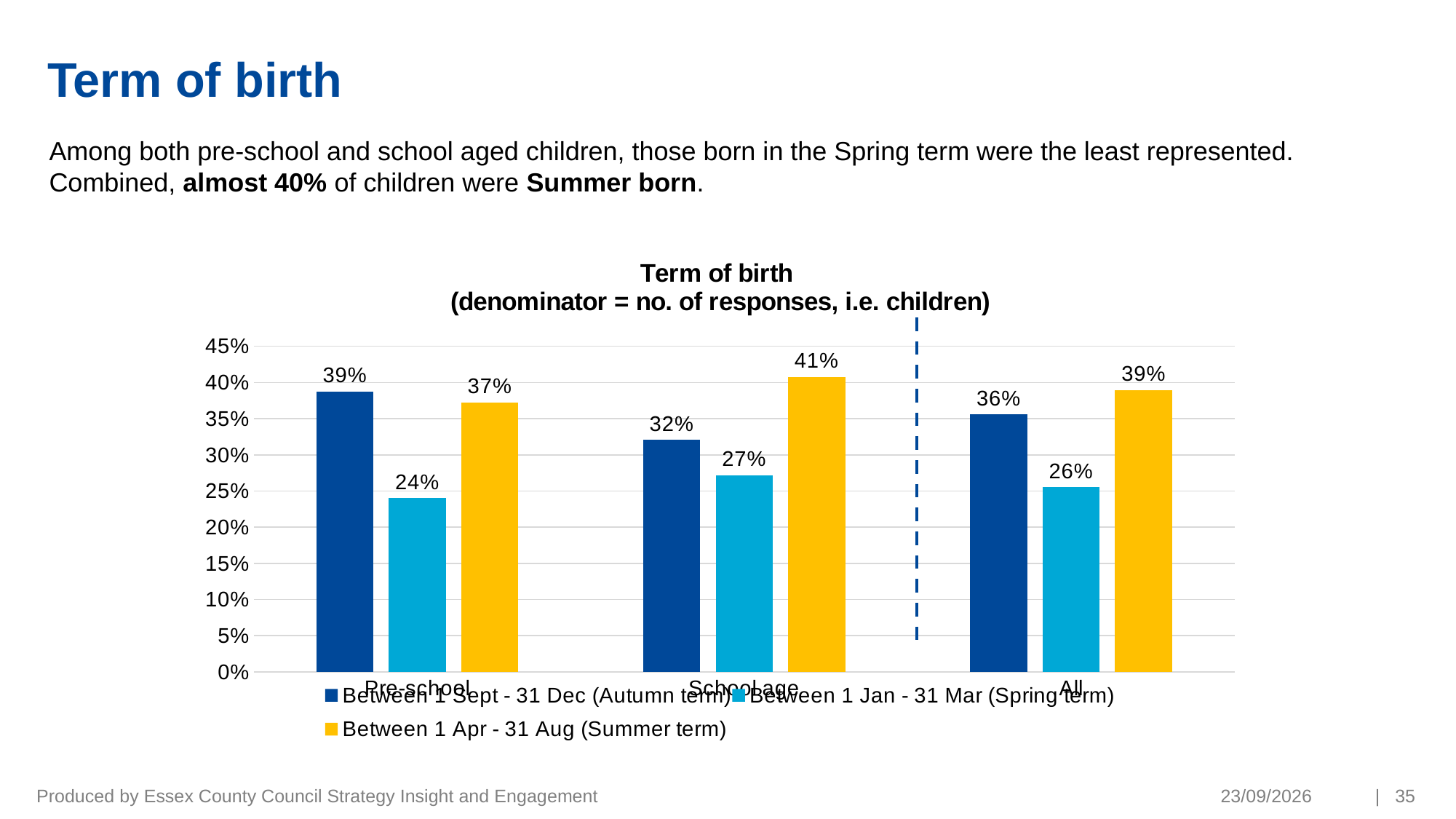
Which series has the lowest value in the Pre-school category? Between 1 Jan - 31 Mar (Spring term) Which is larger: the Autumn term value for Pre-school or the Autumn term value for School age? Pre-school What is the value for the Autumn term series in the Pre-school category? 39% What kind of chart is shown on the slide? Bar chart How many series does the legend list? 3 What is the value for the Spring term series in the All category? 26% Which series has the highest value in the School age category? Between 1 Apr - 31 Aug (Summer term) What colour are the bars for the Summer term series? Yellow What is the value for the Summer term series in the All category? 39% What is the value for the Spring term series in the School age category? 27% What is the difference between the Summer term and Spring term values in the School age category? 14% How many categories are shown on the x axis? 3